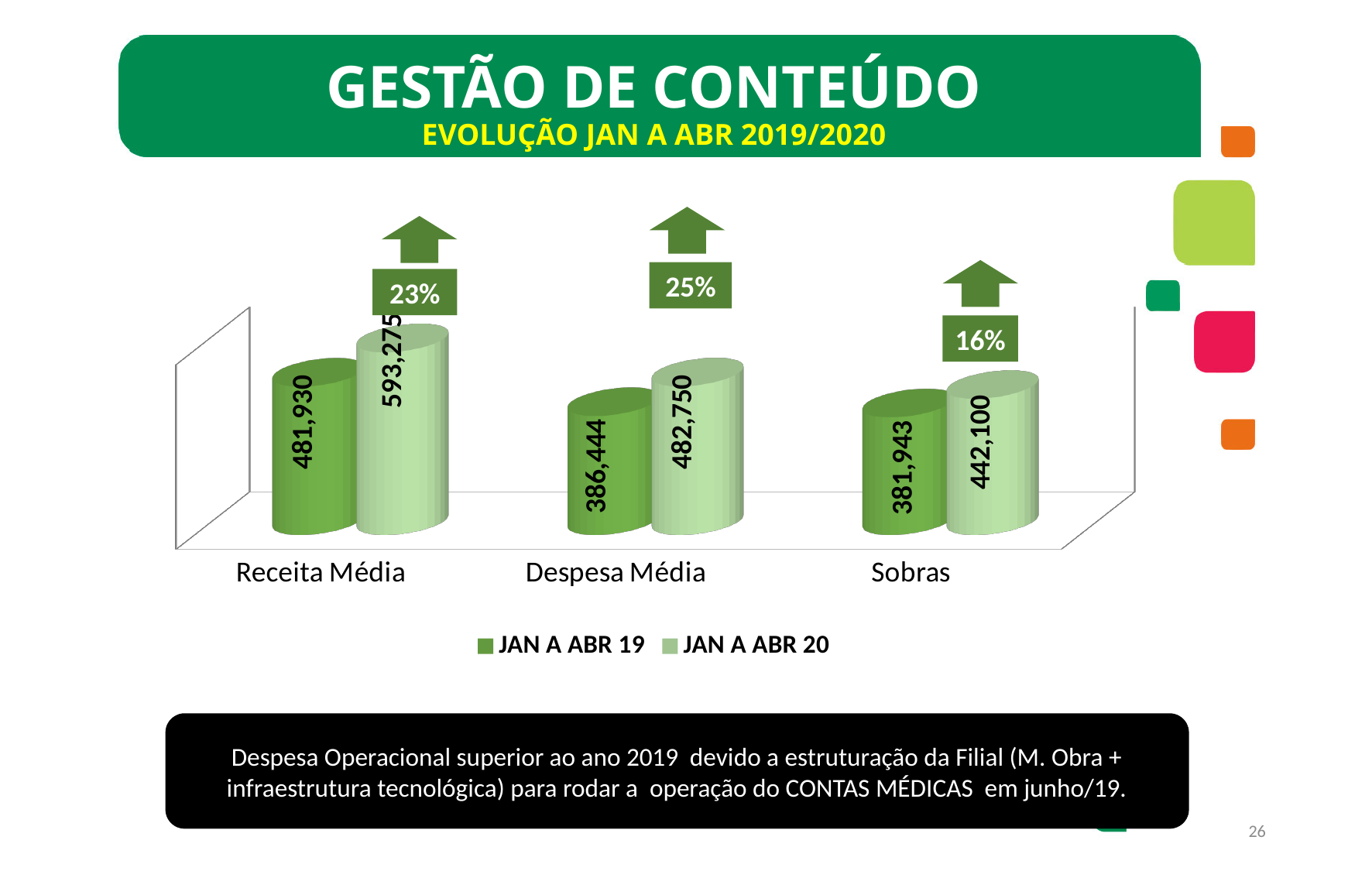
What is the value for Receita Média in the JAN A ABR 19 series? 481,930 Which category has the highest value in the JAN A ABR 20 series? Receita Média How many categories are shown on the x axis of the chart? 3 What is the value for Receita Média in the JAN A ABR 20 series? 593,275 Which is larger: the JAN A ABR 19 value for Despesa Média or the JAN A ABR 19 value for Sobras? Despesa Média How many series does the chart legend list? 2 What is the difference between the JAN A ABR 20 and JAN A ABR 19 values for Sobras? 60,157 What is the value for Despesa Média in the JAN A ABR 20 series? 482,750 What is the value for Sobras in the JAN A ABR 19 series? 381,943 What is the difference between the JAN A ABR 20 and JAN A ABR 19 values for Receita Média? 111,345 Which category has the lowest value in the JAN A ABR 20 series? Sobras What percentage increase is shown above the Despesa Média bars? 25%